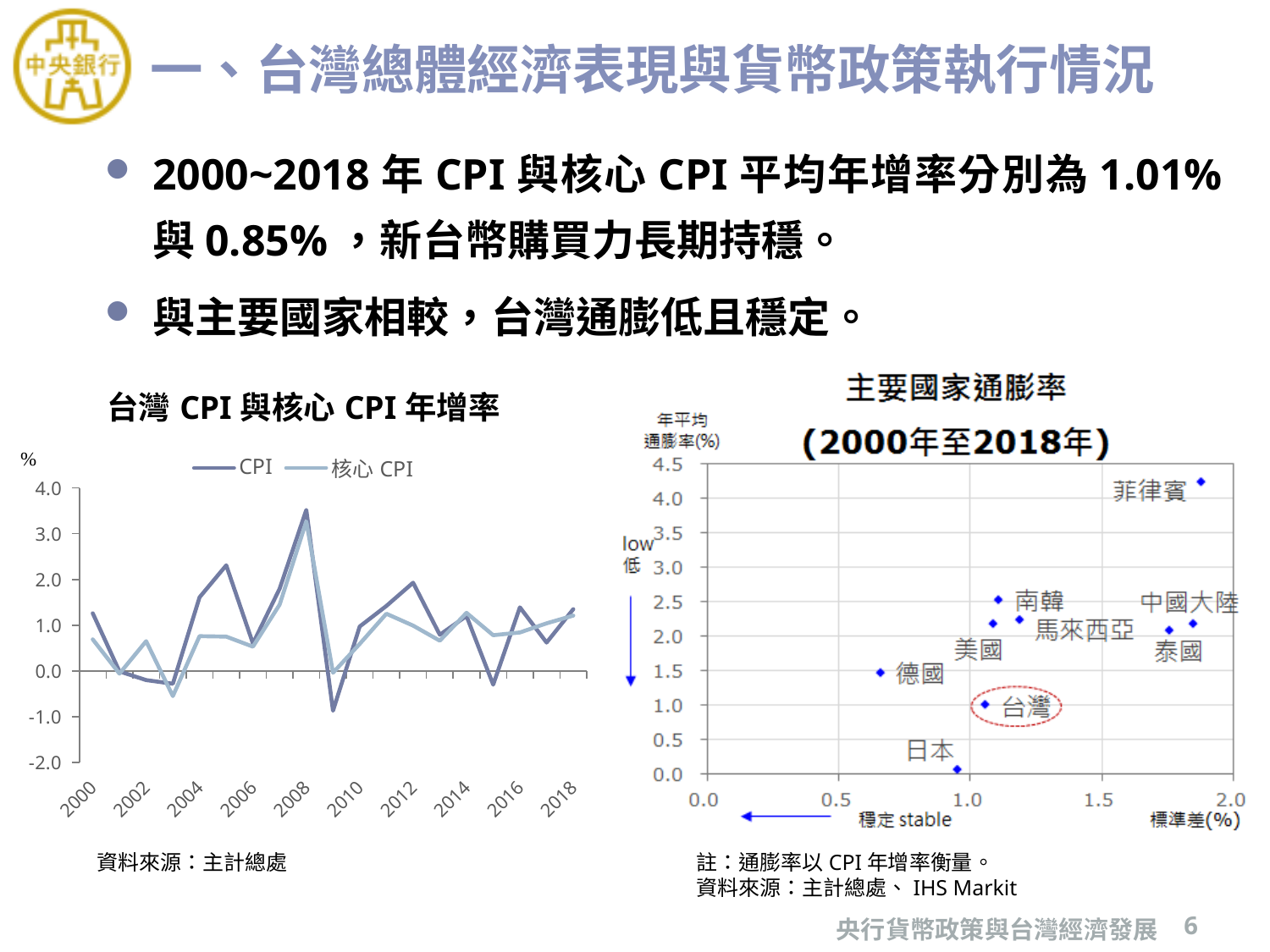
In the left chart (台灣 CPI 與核心 CPI 年增率), is the CPI value for 2008 greater or less than 3.0? greater In the left chart (台灣 CPI 與核心 CPI 年增率), in which year does the CPI series reach its highest value? 2008 In the left chart (台灣 CPI 與核心 CPI 年增率), which series is higher in 2008, CPI or 核心 CPI? CPI How many series does the legend of the left chart (台灣 CPI 與核心 CPI 年增率) list? 2 In the right chart (主要國家通膨率), is the average inflation rate for 台灣 greater or less than 1.5? less In the left chart (台灣 CPI 與核心 CPI 年增率), in which year does the CPI series reach its lowest value? 2009 In the right chart (主要國家通膨率), which country has the lowest average inflation rate? 日本 What kind of chart is the left chart titled 台灣 CPI 與核心 CPI 年增率? line chart In the right chart (主要國家通膨率), which country has the highest average inflation rate? 菲律賓 What kind of chart is the right chart titled 主要國家通膨率 (2000年至2018年)? scatter chart How many countries or regions are plotted in the right chart (主要國家通膨率)? 9 In the left chart (台灣 CPI 與核心 CPI 年增率), is the CPI value for 2009 greater or less than 0.0? less